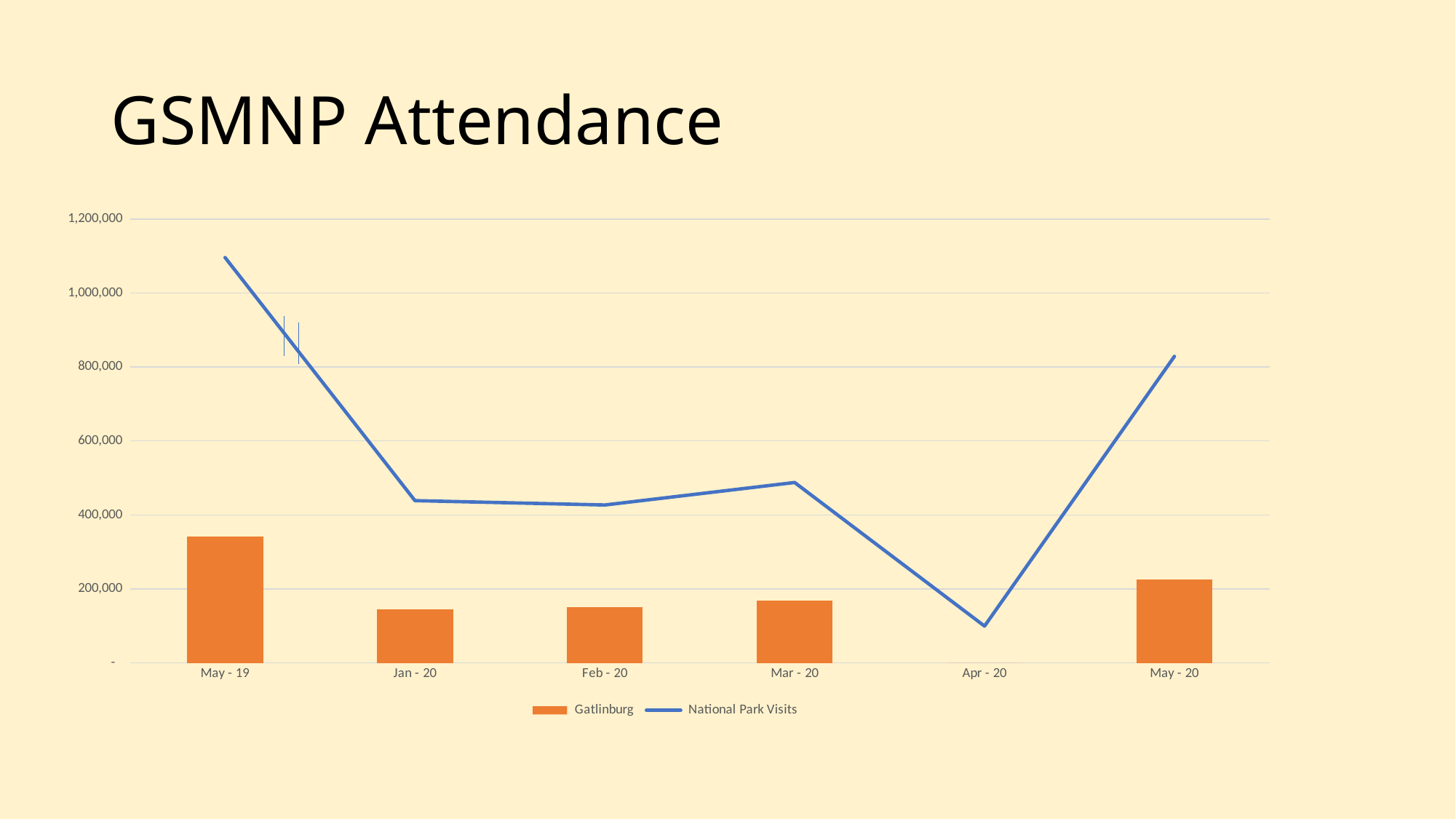
How many series does the legend list? 2 Is the National Park Visits value for Apr - 20 greater or less than 200,000? less In which month is the National Park Visits value highest? May - 19 In which month is the National Park Visits value lowest? Apr - 20 Which series is shown as a line? National Park Visits Does the National Park Visits line rise or fall from Apr - 20 to May - 20? rise How many categories are shown on the x axis? 6 What is the title of the chart? GSMNP Attendance Is the National Park Visits value for May - 19 greater or less than 1,000,000? greater Which month has the tallest Gatlinburg bar? May - 19 Which is larger, the National Park Visits value for May - 19 or for May - 20? May - 19 Is the Gatlinburg value for May - 20 greater or less than 200,000? greater